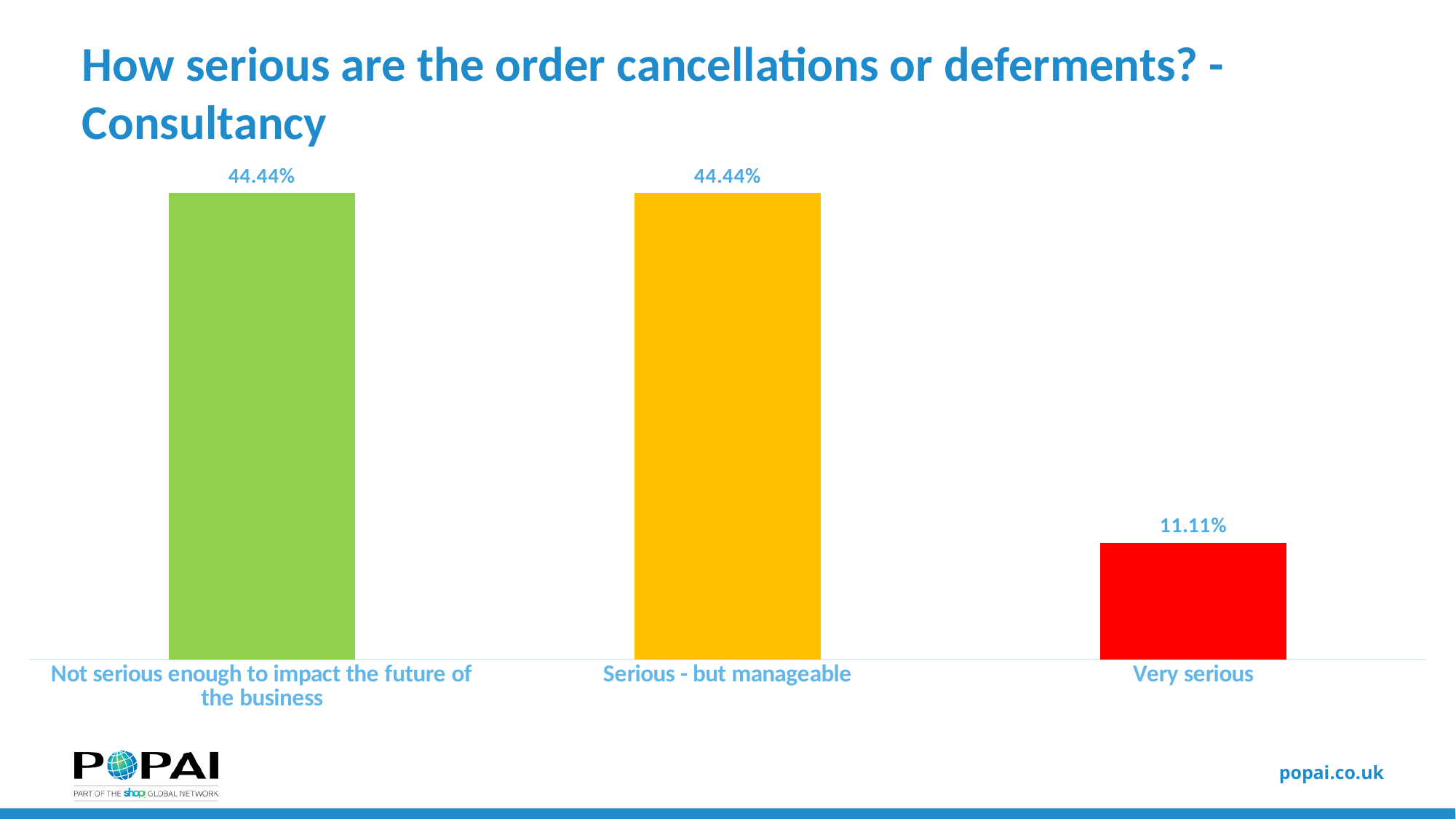
What is the value for "Not serious enough to impact the future of the business"? 44.44% Which category has the lowest value? Very serious Do the values for "Not serious enough to impact the future of the business" and "Serious - but manageable" differ? No, both are 44.44% What colour is the bar for "Very serious"? Red What is the value for "Very serious"? 11.11% What is the difference between the values for "Serious - but manageable" and "Very serious"? 33.33% What is the value for "Serious - but manageable"? 44.44% What is the title of the chart? How serious are the order cancellations or deferments? - Consultancy Which is larger: the value for "Not serious enough to impact the future of the business" or the value for "Very serious"? Not serious enough to impact the future of the business What kind of chart is shown on the slide? Bar chart How many categories are shown in the chart? 3